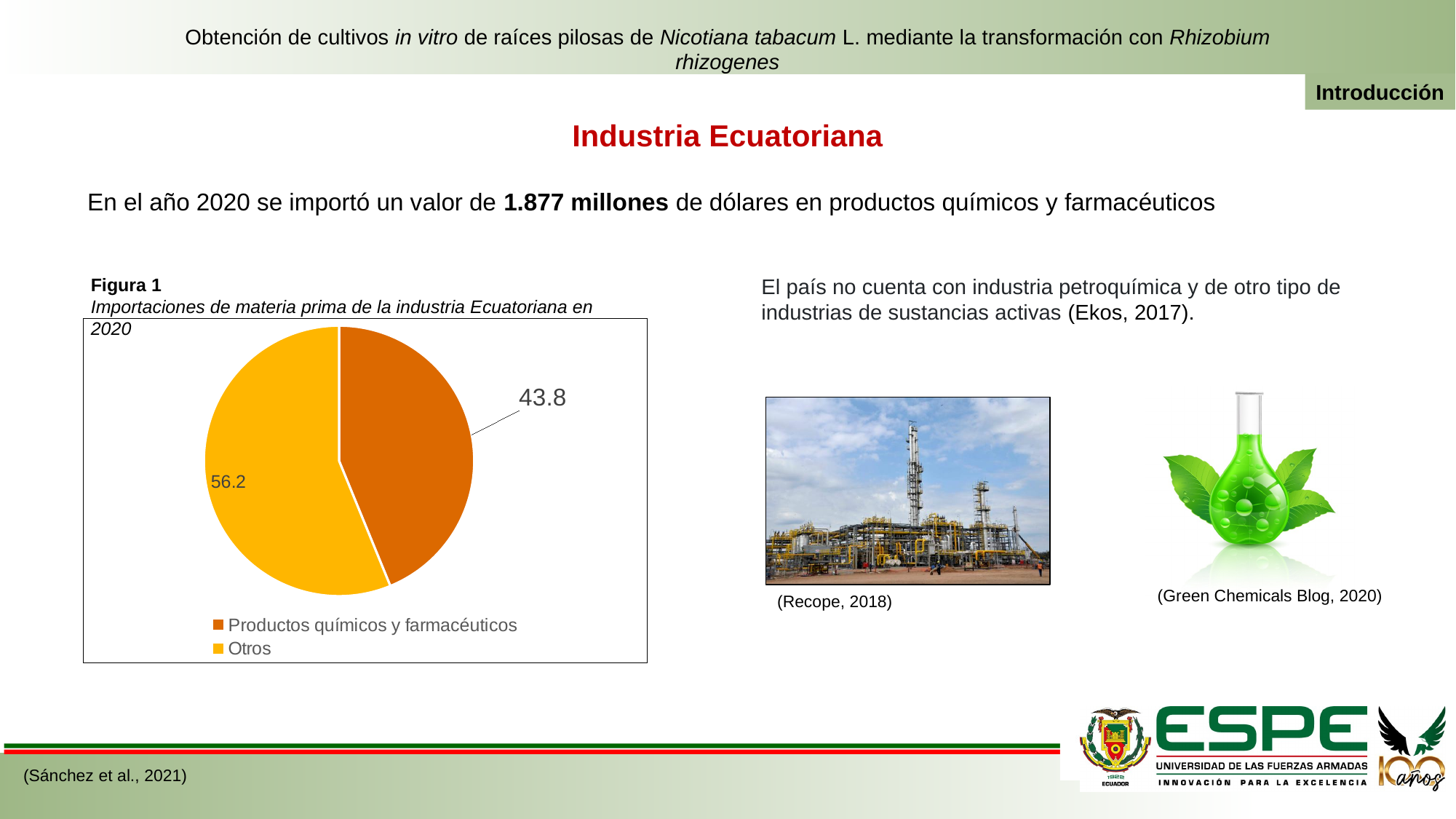
What is the difference between the Otros slice and the Productos químicos y farmacéuticos slice? 12.4 Which slice of the pie chart is the largest? Otros How many slices does the pie chart have? 2 How many entries does the legend of the pie chart list? 2 What is the caption title of the figure containing the pie chart? Importaciones de materia prima de la industria Ecuatoriana en 2020 Which slice of the pie chart is the smallest? Productos químicos y farmacéuticos What is the value for Otros in the pie chart? 56.2 What is the value for Productos químicos y farmacéuticos in the pie chart? 43.8 What kind of chart is shown in Figura 1? pie chart Which is larger in the pie chart, Otros or Productos químicos y farmacéuticos? Otros What colour is the Otros slice in the pie chart? yellow